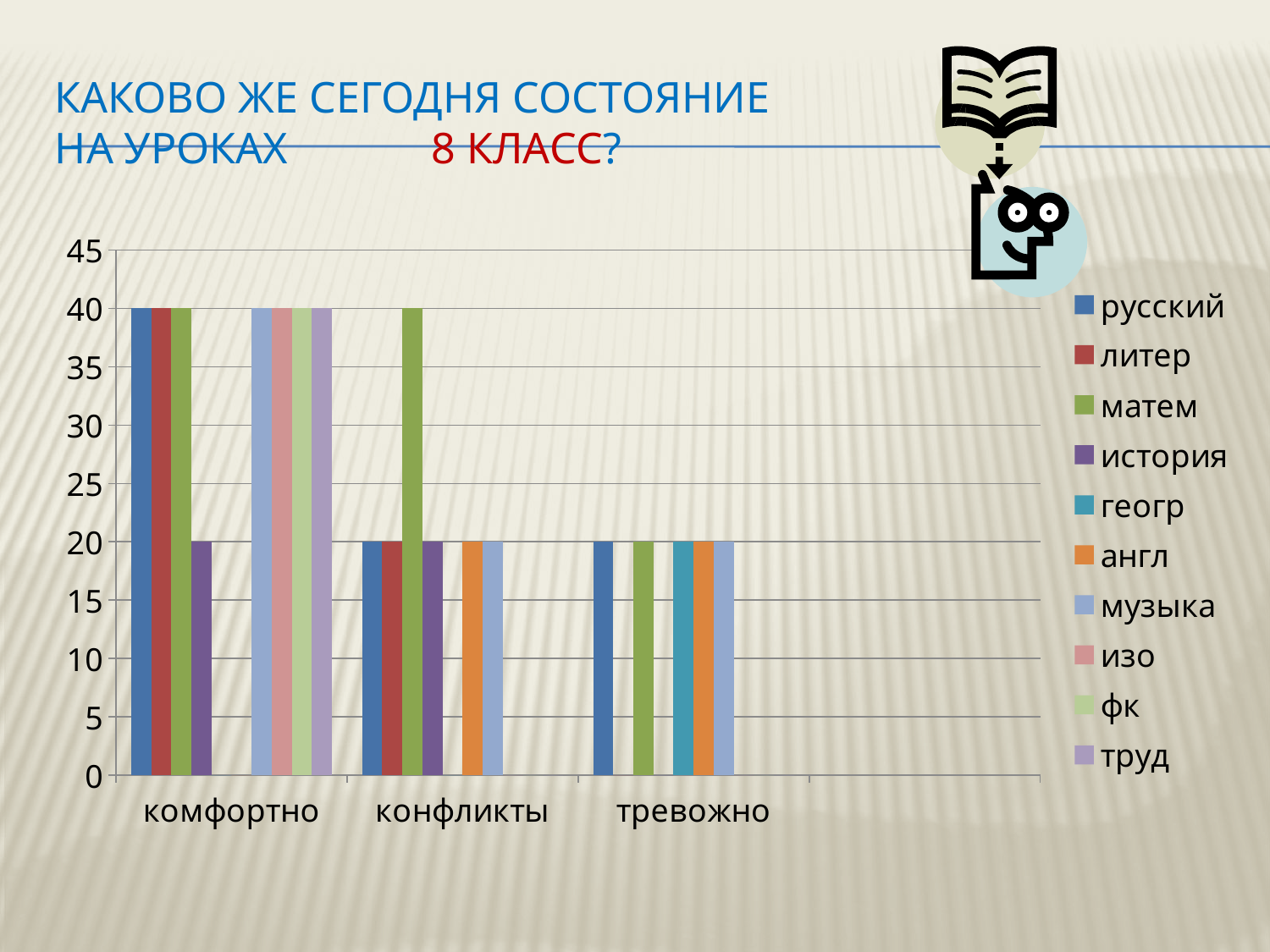
Is the value for англ in the конфликты category greater or less than 30? less How many categories are shown on the x axis of the chart? 3 What is the value for русский in the комфортно category? 40 What is the value for история in the комфортно category? 20 What is the value for матем in the конфликты category? 40 What kind of chart is shown on the slide? bar chart What is the value for геогр in the тревожно category? 20 What is the difference between the матем and русский values in the конфликты category? 20 Which series has the highest value in the конфликты category? матем In the комфортно category, which is larger: the value for русский or the value for история? русский How many series does the chart's legend list? 10 Which series is listed first in the chart's legend? русский